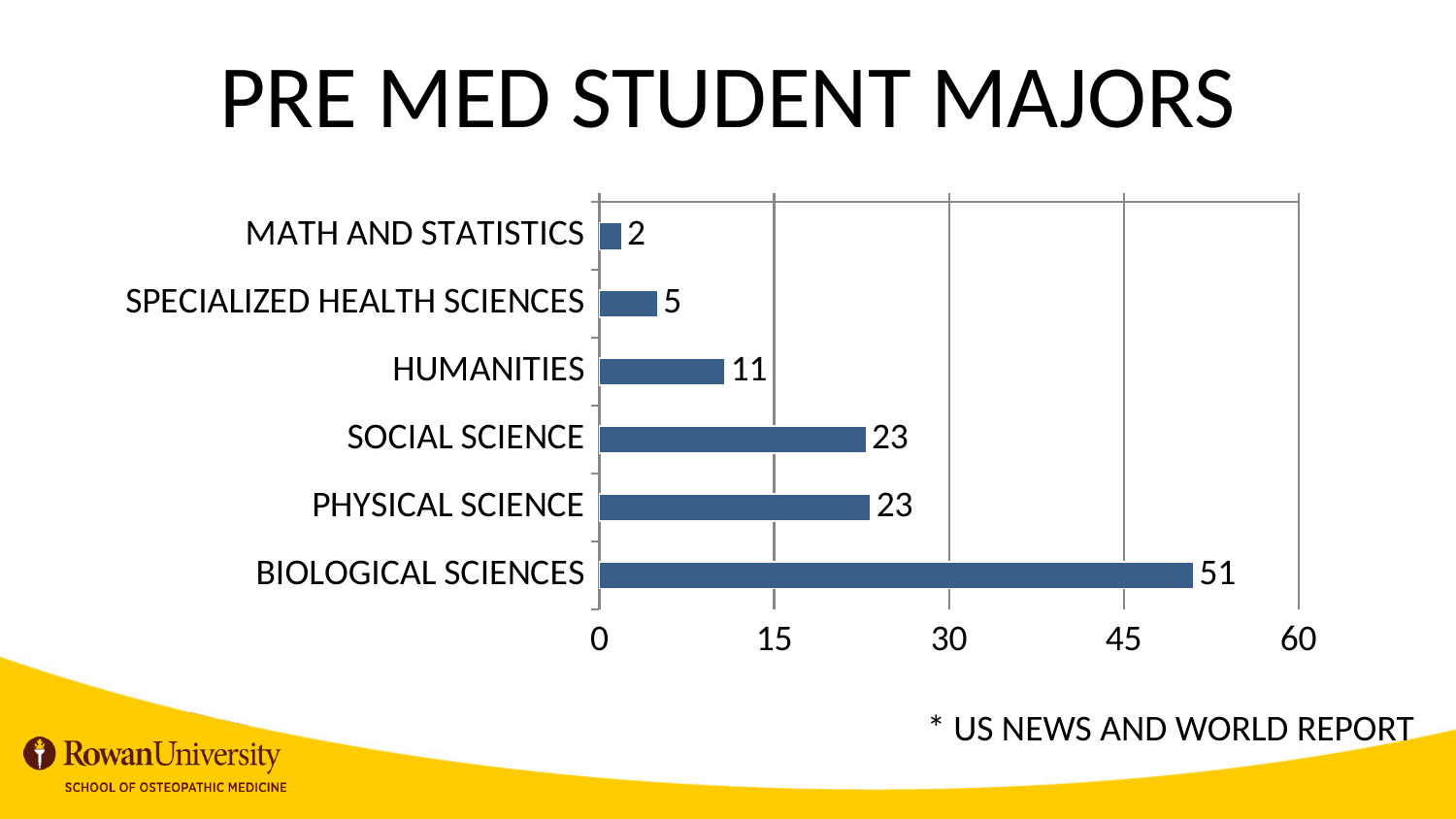
What is the title of the chart? PRE MED STUDENT MAJORS What is the value for Math and Statistics? 2 What is the value for Biological Sciences? 51 Which is larger, the value for Humanities or the value for Physical Science? Physical Science What is the value for Specialized Health Sciences? 5 What kind of chart is shown on the slide? Bar chart What is the value for Humanities? 11 Which major has the highest value? Biological Sciences What is the difference between the values for Biological Sciences and Social Science? 28 How many majors are shown in the chart? 6 Which major has the lowest value? Math and Statistics What is the difference between the values for Humanities and Specialized Health Sciences? 6